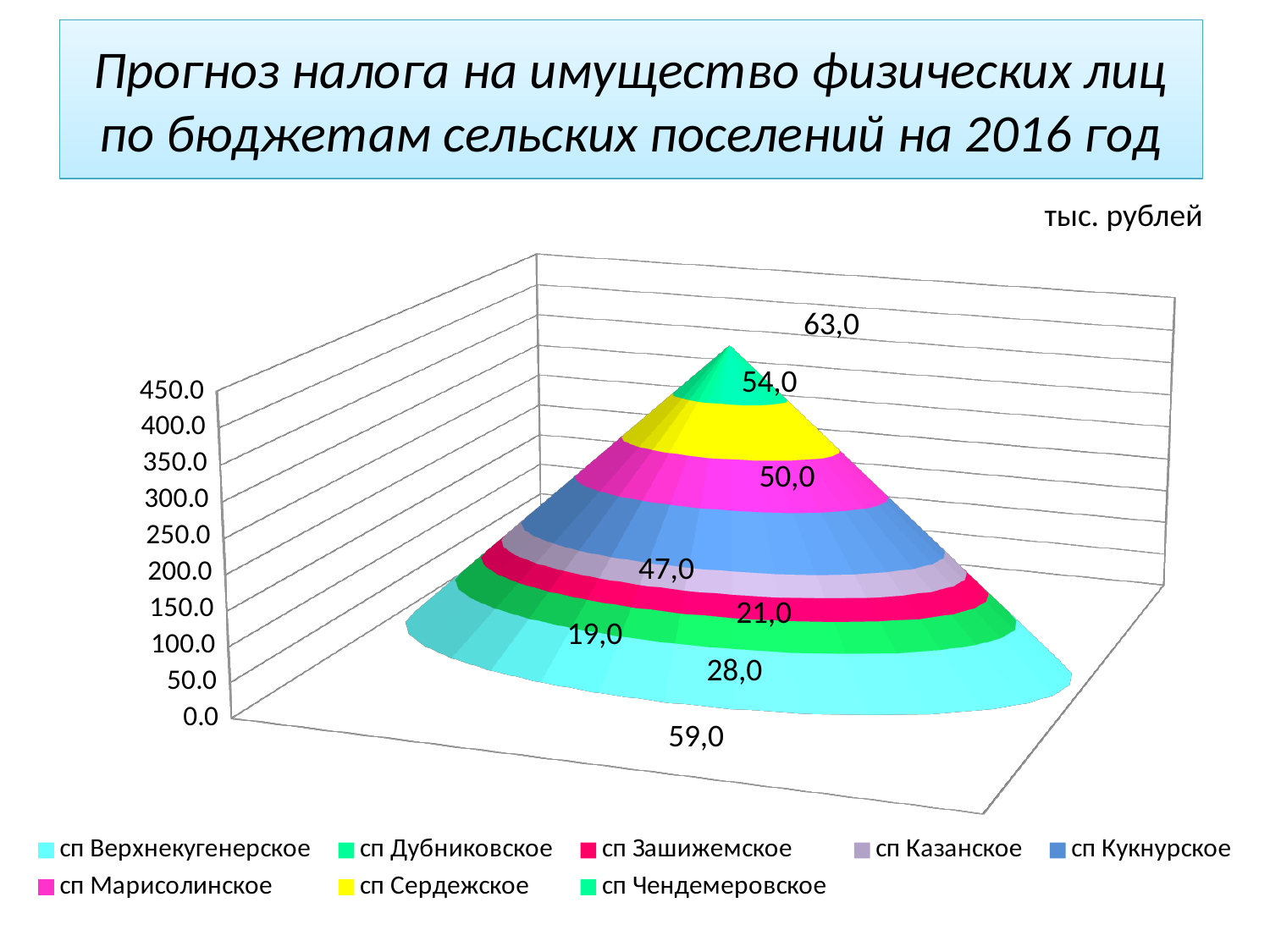
What is the value for сп Кукнурское? 47,0 What is the value for сп Марисолинское? 50,0 Which settlement has the lowest value? сп Зашижемское Which is larger, the value for сп Дубниковское or сп Зашижемское? сп Дубниковское What is the value for сп Чендемеровское? 63,0 How many series does the legend list? 8 Which settlement has the highest value? сп Чендемеровское What is the total of all the stacked segments? 341,0 What is the value for сп Сердежское? 54,0 What is the value for сп Верхнекугенерское? 59,0 What is the difference between the values for сп Чендемеровское and сп Казанское? 42,0 What unit is stated above the chart? тыс. рублей